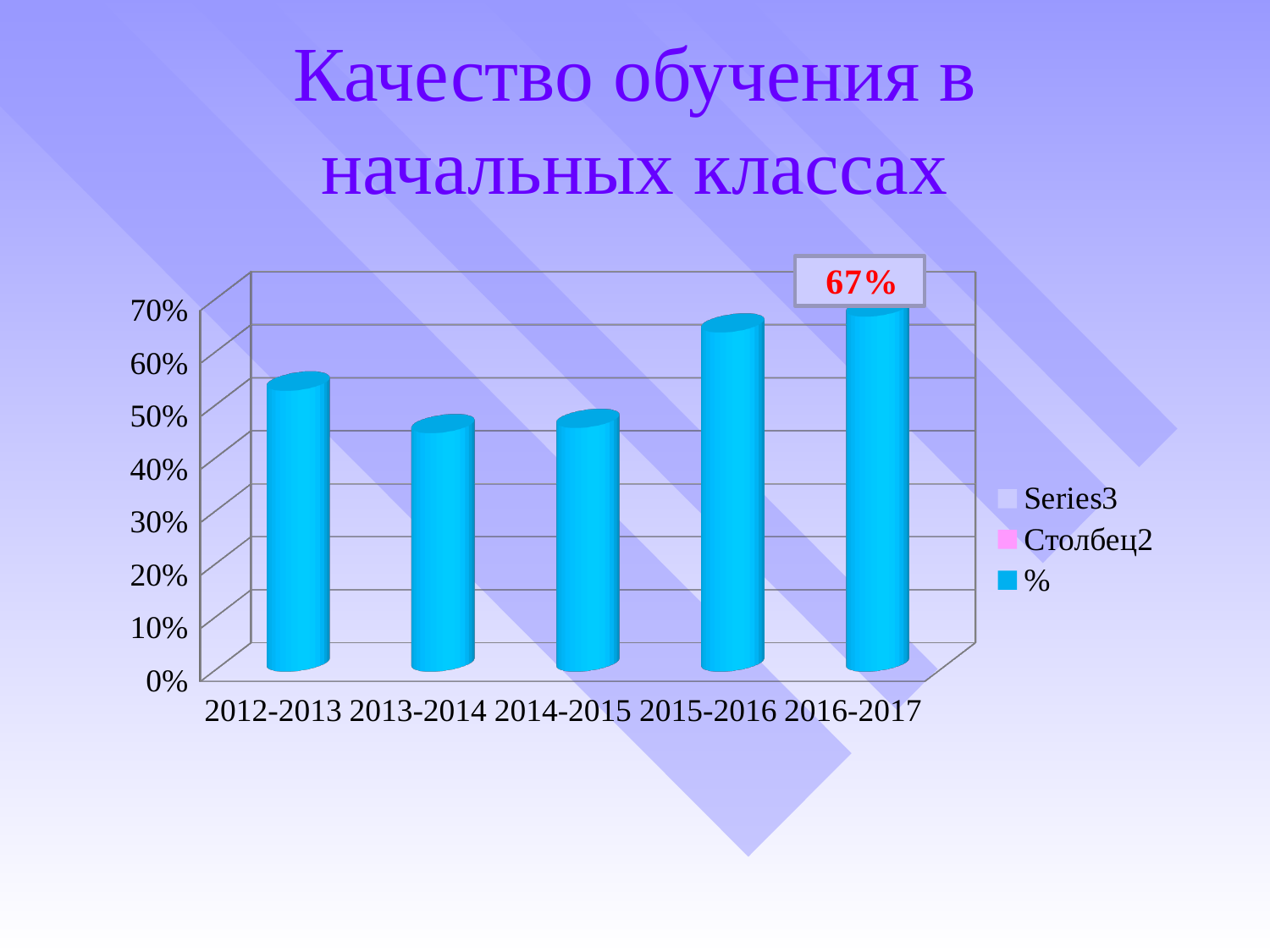
Which is larger, the value for 2012-2013 or the value for 2013-2014? 2012-2013 Is the value for 2013-2014 greater or less than 50%? less Which school year has the highest value? 2016-2017 How many school years are shown on the x axis? 5 Is the value for 2015-2016 greater or less than 60%? greater Which is larger, the value for 2014-2015 or the value for 2015-2016? 2015-2016 What kind of chart is shown on the slide? bar chart Is the value for 2014-2015 greater or less than 50%? less What is the value for 2016-2017? 67% Do the values rise or fall from 2014-2015 to 2016-2017? rise How many entries does the legend list? 3 What is the title of the slide? Качество обучения в начальных классах